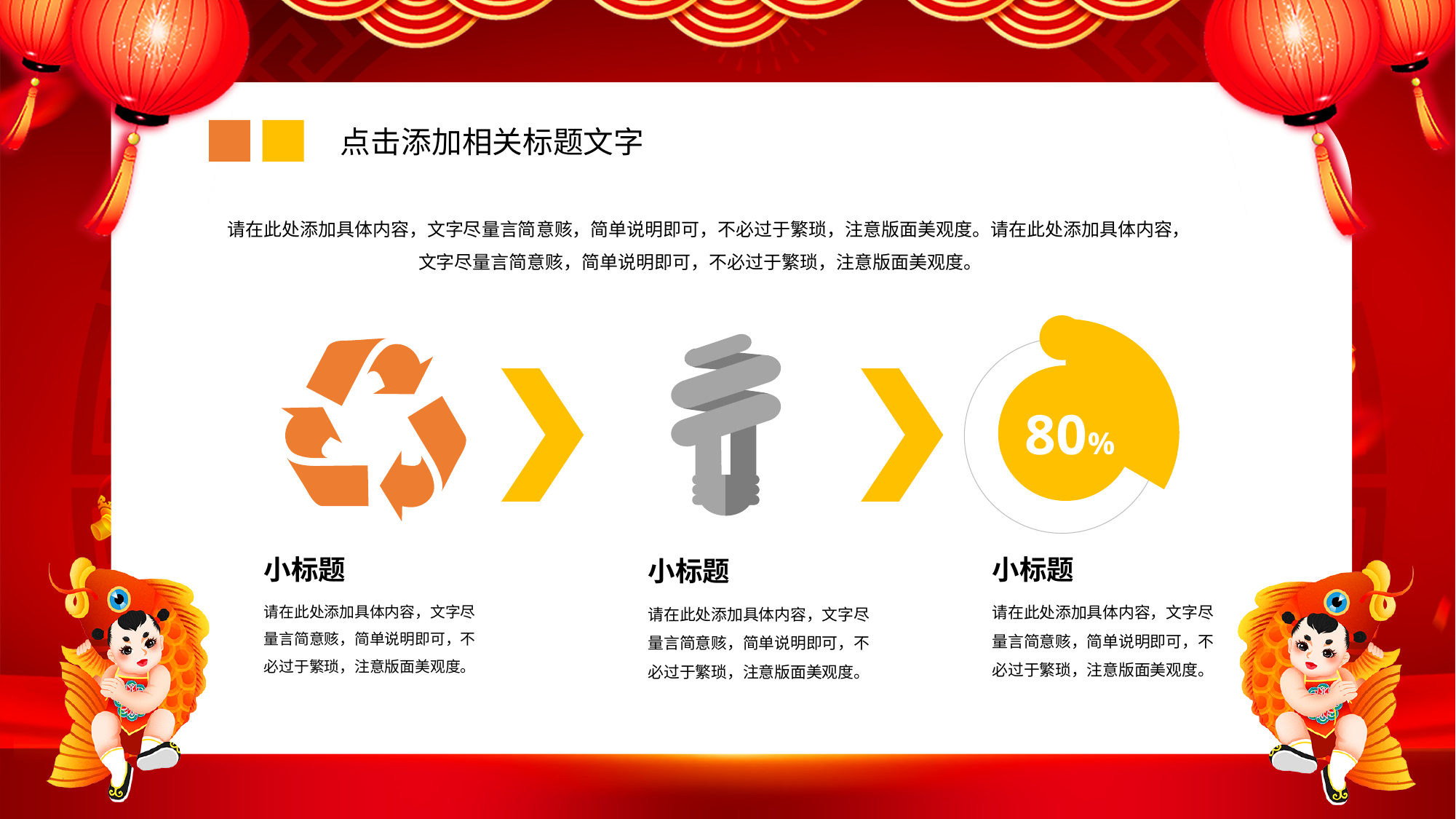
What kind of chart is shown on the right side of the slide, under the third arrow? donut (ring) chart How many ring charts are shown on the slide? 1 What colour is the filled portion of the ring chart on the right of the slide? yellow What percentage is printed in the centre of the ring chart on the right of the slide? 80% Is the value shown in the ring chart on the right greater or less than 50%? greater